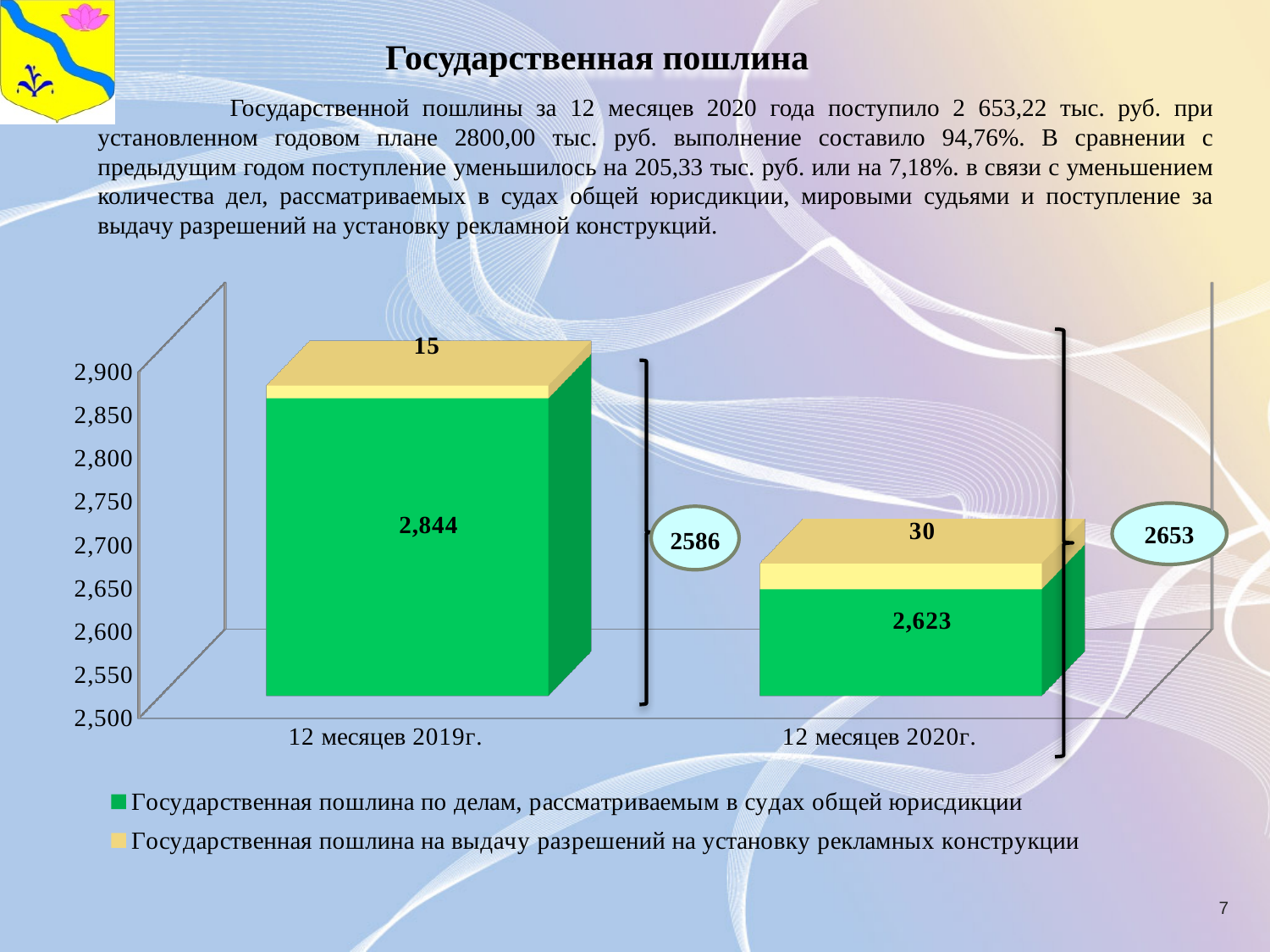
Which category has the higher value for 'Государственная пошлина по делам, рассматриваемым в судах общей юрисдикции'? 12 месяцев 2019г. How many categories are shown on the x axis of the chart? 2 Which colour represents 'Государственная пошлина на выдачу разрешений на установку рекламных конструкции' in the chart? yellow Does the value of 'Государственная пошлина по делам, рассматриваемым в судах общей юрисдикции' rise or fall from '12 месяцев 2019г.' to '12 месяцев 2020г.'? fall What type of chart is shown on the slide? bar chart How many series does the chart legend list? 2 What is the value of 'Государственная пошлина на выдачу разрешений на установку рекламных конструкции' for '12 месяцев 2019г.'? 15 What is the value of 'Государственная пошлина на выдачу разрешений на установку рекламных конструкции' for '12 месяцев 2020г.'? 30 What is the value of 'Государственная пошлина по делам, рассматриваемым в судах общей юрисдикции' for '12 месяцев 2020г.'? 2,623 Which category has the lower value for 'Государственная пошлина на выдачу разрешений на установку рекламных конструкции'? 12 месяцев 2019г. What is the value of 'Государственная пошлина по делам, рассматриваемым в судах общей юрисдикции' for '12 месяцев 2019г.'? 2,844 What is the difference between the 2019 and 2020 values of 'Государственная пошлина по делам, рассматриваемым в судах общей юрисдикции'? 221